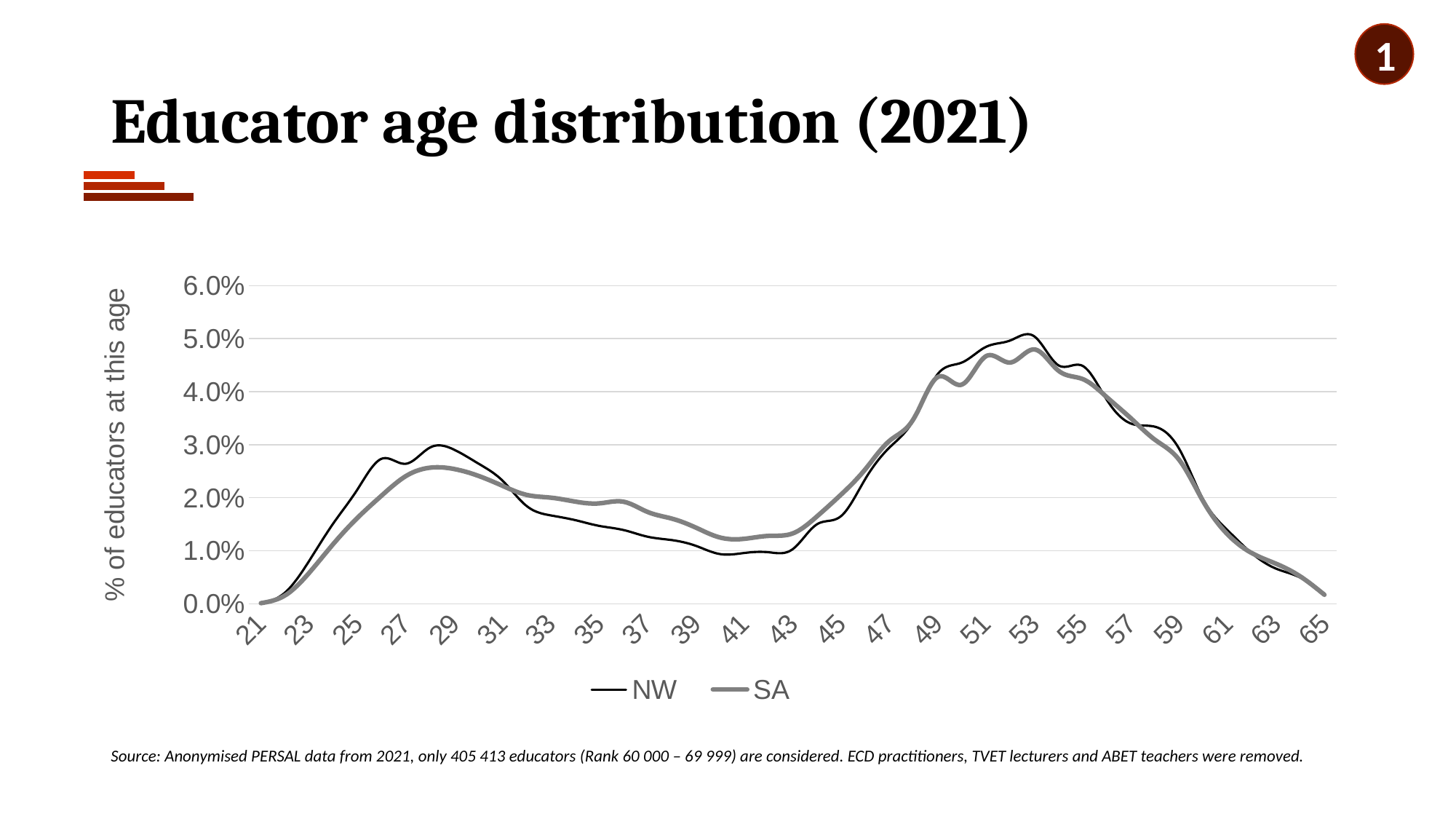
What is the label on the vertical axis? % of educators at this age Is the value for SA at age 65 greater or less than 1.0%? less What is the title of the chart? Educator age distribution (2021) What kind of chart is shown on the slide? Line chart Is the value for SA at age 41 greater or less than 2.0%? less At age 33, which series has the larger value, NW or SA? SA Between ages 43 and 53, does the NW line rise or fall? Rise At which age does the NW line reach its highest value? 53 Is the value for NW at age 53 greater or less than 4.0%? greater At age 29, which series has the larger value, NW or SA? NW How many series does the legend list? 2